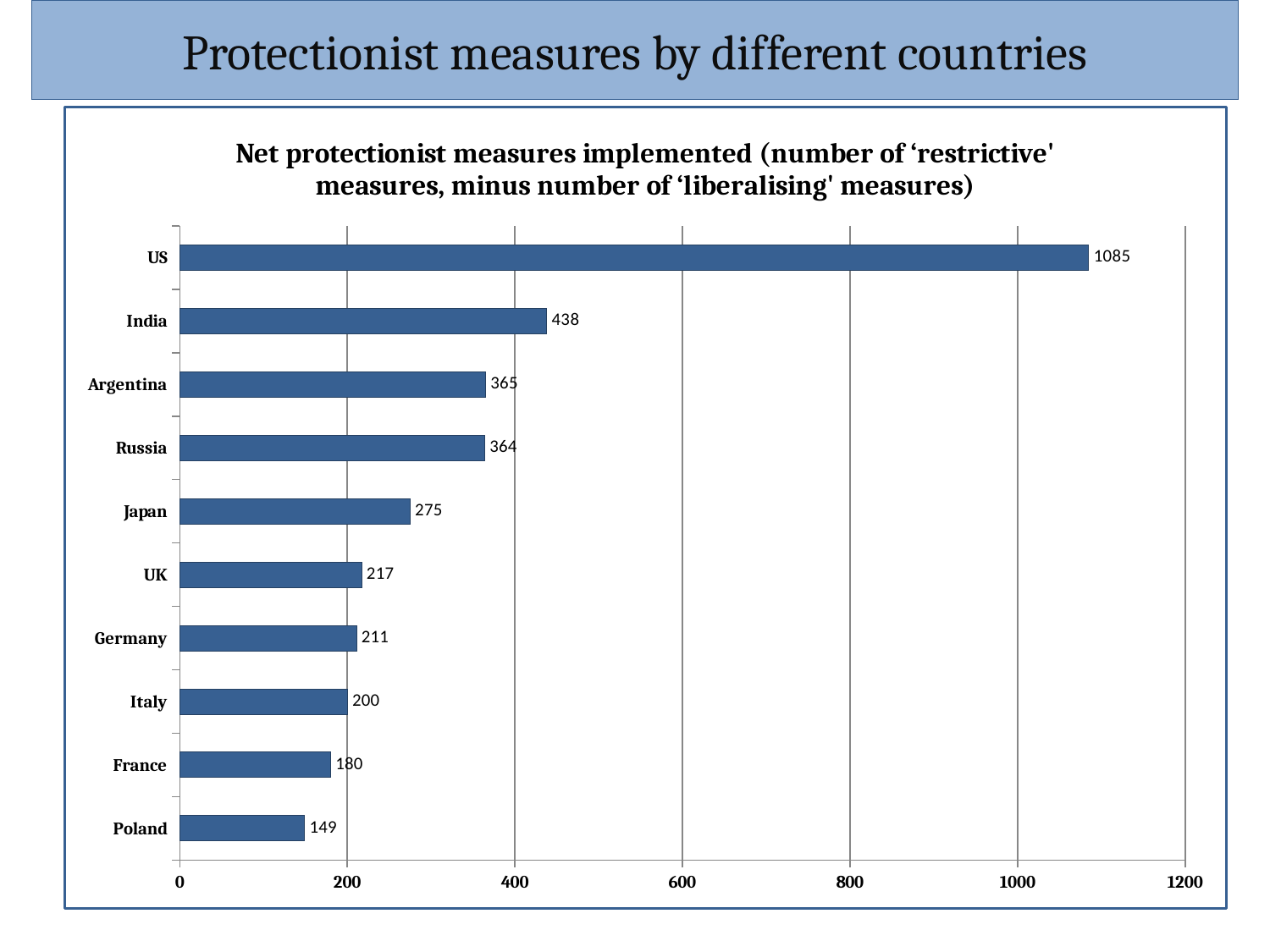
Which has a larger value, India or Japan? India What is the value for Poland? 149 Is the value for France greater or less than 200? less What is the value for Japan? 275 What is the difference between the values for the US and India? 647 How many countries are shown in the chart? 10 Which country has the lowest value? Poland What is the difference between the values for the UK and Germany? 6 Which country has the highest value? US What kind of chart is shown on the slide? bar chart What is the title of the chart? Net protectionist measures implemented (number of 'restrictive' measures, minus number of 'liberalising' measures) What is the value for the US? 1085